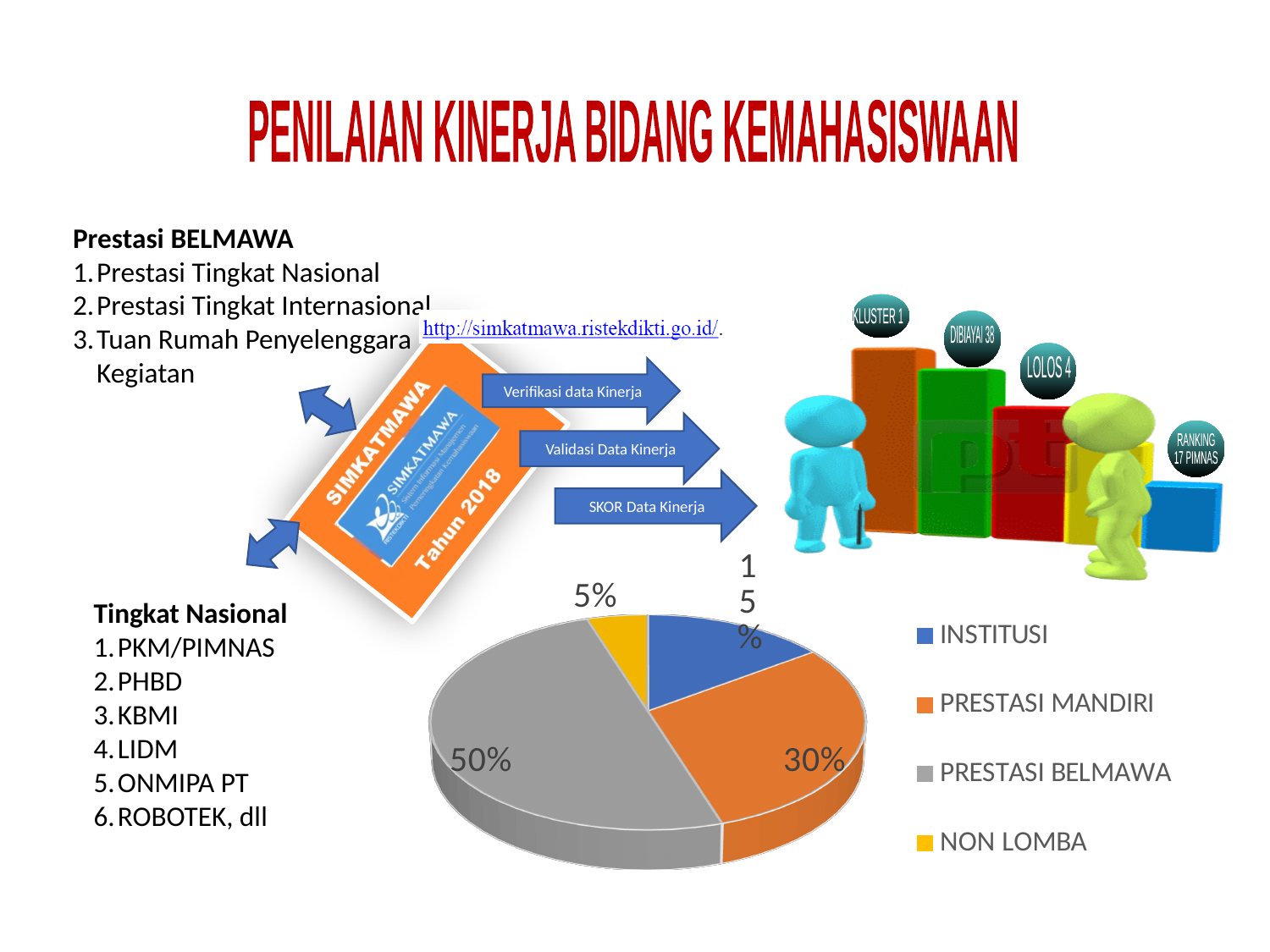
What share of the pie does PRESTASI MANDIRI have? 30% Which legend entry is shown in orange? PRESTASI MANDIRI Which is larger, the INSTITUSI slice or the NON LOMBA slice? INSTITUSI What share of the pie does PRESTASI BELMAWA have? 50% What is the difference in percentage points between PRESTASI BELMAWA and PRESTASI MANDIRI? 20 What colour is the PRESTASI BELMAWA slice in the pie chart? gray Which category has the smallest slice of the pie? NON LOMBA Which category has the largest slice of the pie? PRESTASI BELMAWA What share of the pie does NON LOMBA have? 5% What kind of chart is shown on the slide? pie chart How many categories does the pie chart show? 4